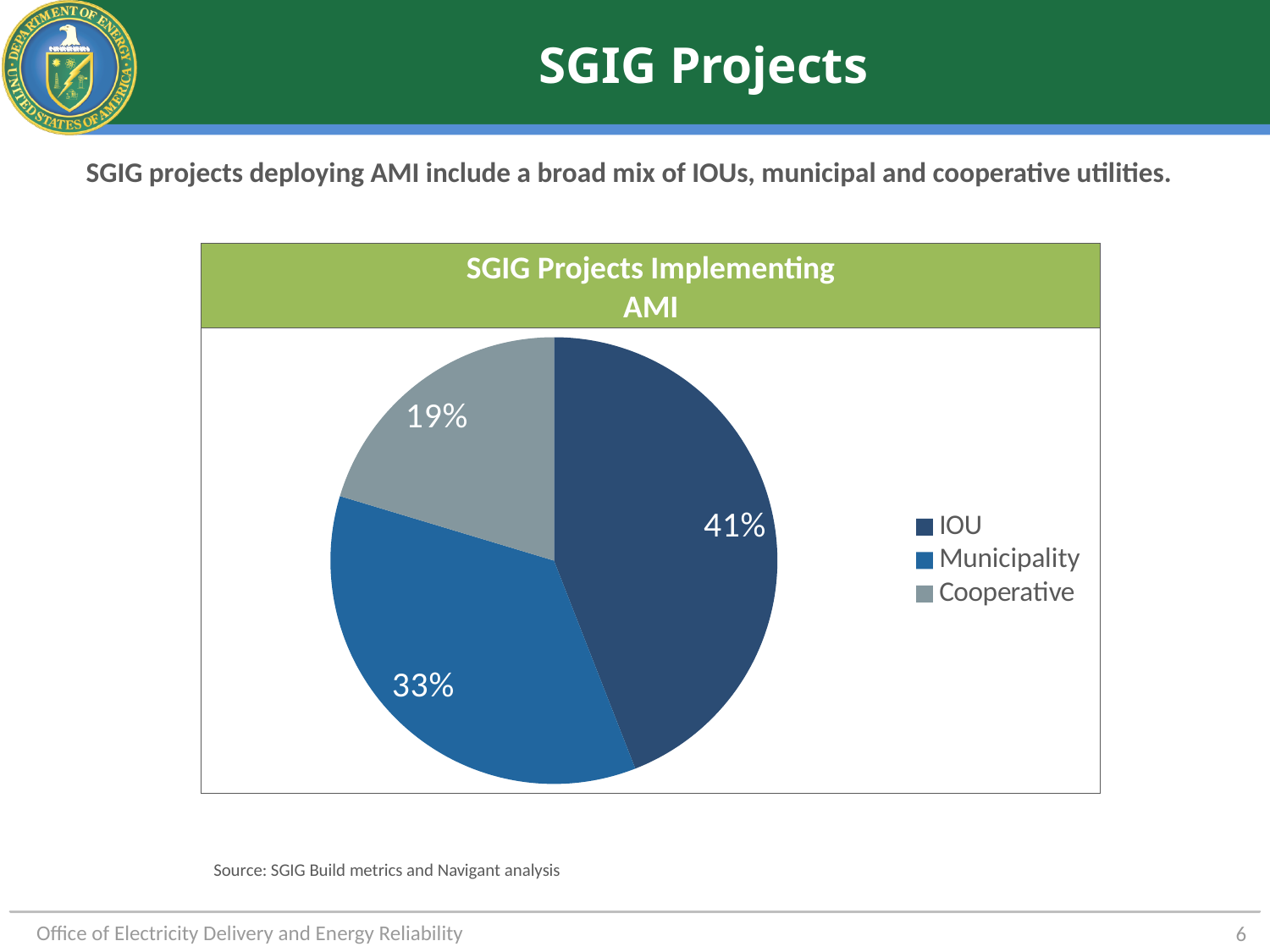
How many categories does the pie chart show? 3 What is the difference in percentage points between the IOU share and the Cooperative share? 22 Which is larger, the Municipality share or the Cooperative share? Municipality Which legend entry is shown in grey? Cooperative What share of SGIG projects implementing AMI are IOUs? 41% Which category has the largest share of the pie? IOU What kind of chart is shown on the slide? pie chart Which category has the smallest share of the pie? Cooperative What share of SGIG projects implementing AMI are cooperatives? 19% What is the title of the chart? SGIG Projects Implementing AMI How many entries does the legend list? 3 What share of SGIG projects implementing AMI are municipalities? 33%